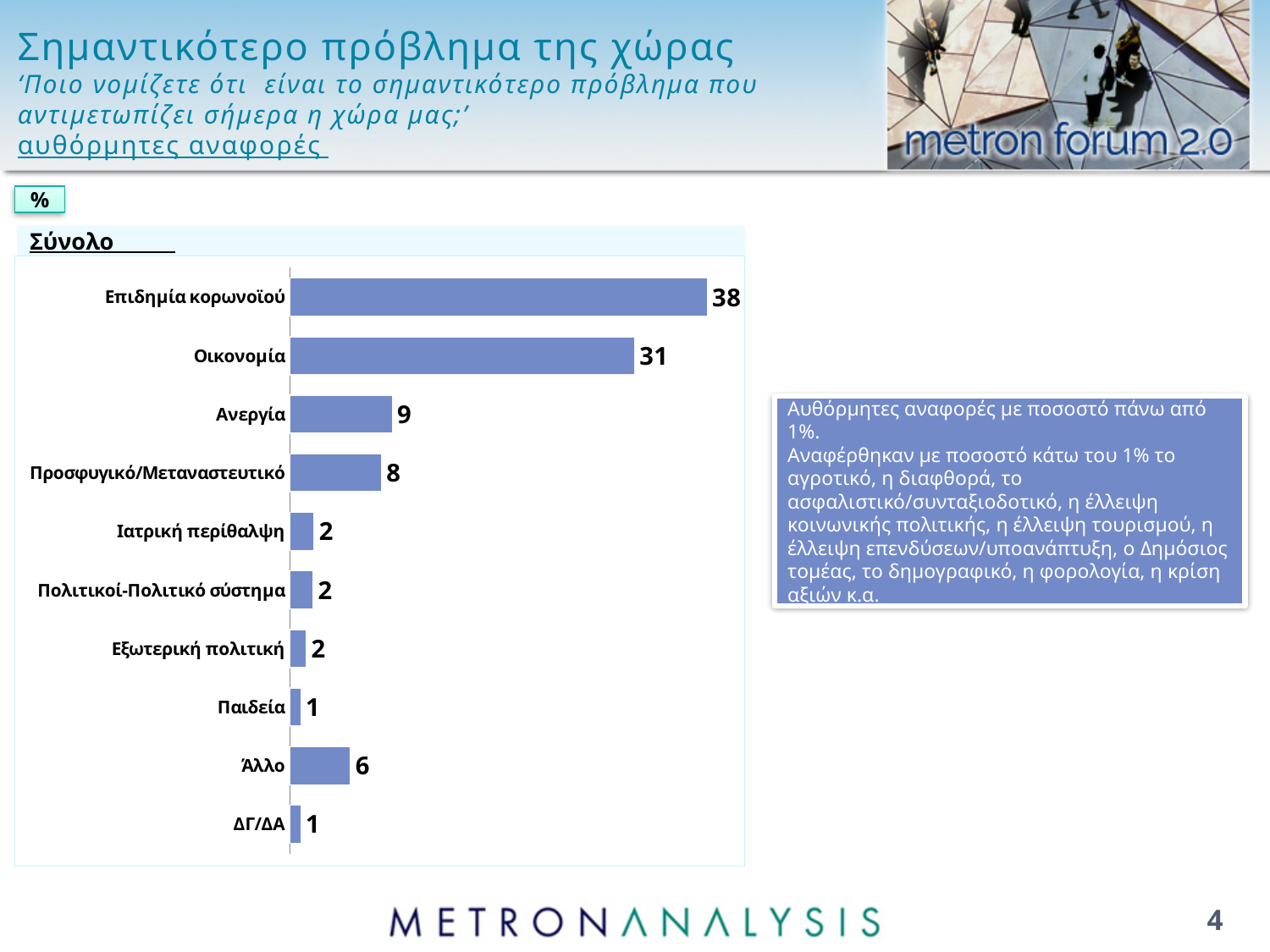
What value is shown for Άλλο? 6 What value is shown for Οικονομία? 31 What value is shown for Προσφυγικό/Μεταναστευτικό? 8 What kind of chart is shown on the slide? Bar chart How many categories are shown in the chart? 10 Which is larger, the value for Οικονομία or the value for Προσφυγικό/Μεταναστευτικό? Οικονομία What is the difference between the values for Ανεργία and Προσφυγικό/Μεταναστευτικό? 1 What value is shown for Επιδημία κορωνοϊού? 38 Which category has the highest value? Επιδημία κορωνοϊού What is the heading shown above the chart? Σύνολο Which is larger, the value for Ανεργία or the value for Άλλο? Ανεργία What is the difference between the values for Επιδημία κορωνοϊού and Οικονομία? 7